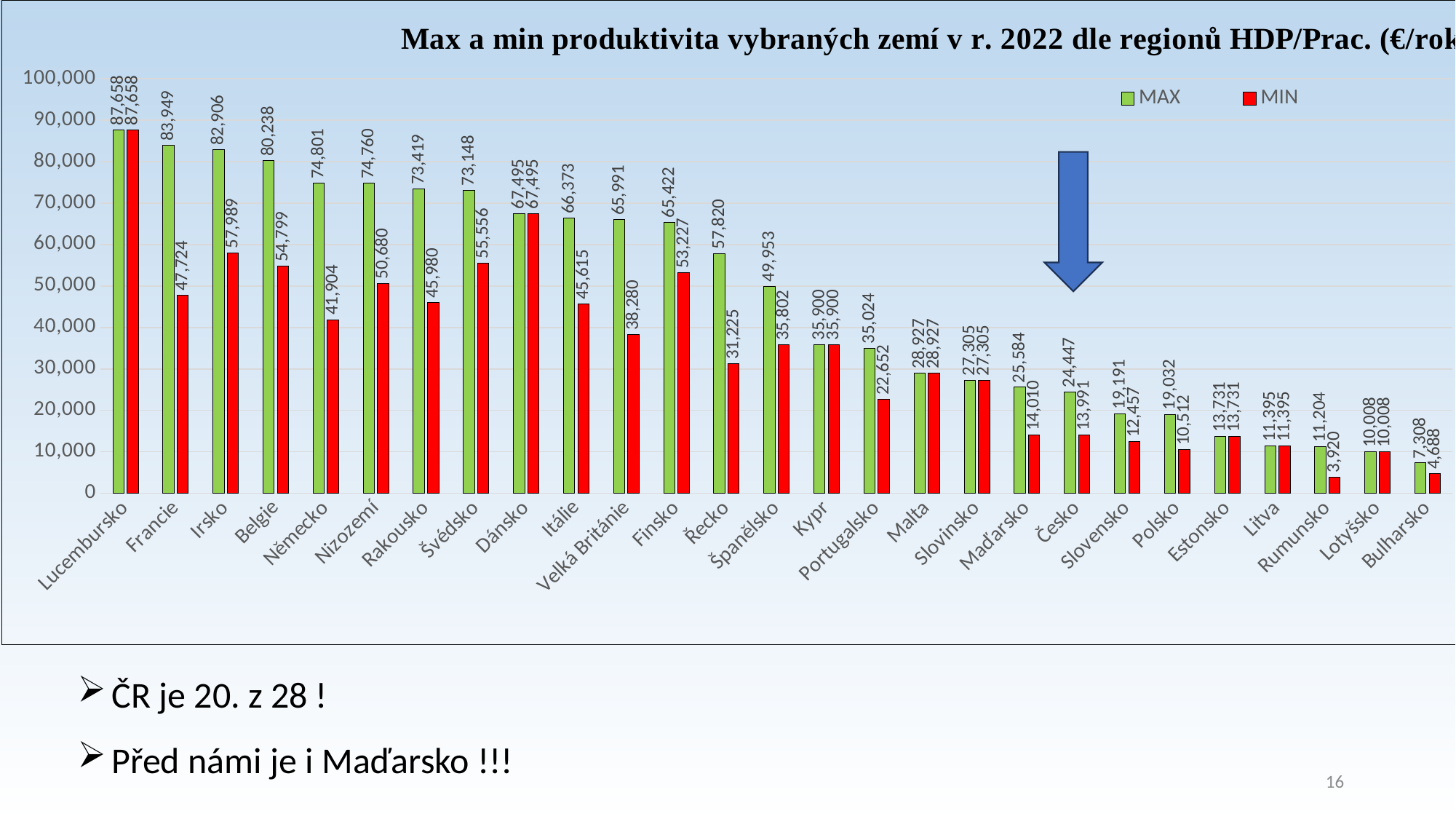
What is the MIN value for Maďarsko? 14,010 Is the MAX value for Řecko greater or less than 50,000? greater How many series does the legend list? 2 How many countries are shown on the x axis? 27 Which country has the lowest MIN value? Rumunsko What is the MIN value for Německo? 41,904 What kind of chart is shown? bar chart Do the MAX values rise or fall from left to right along the x axis? fall What is the MAX value for Česko? 24,447 Which country has the highest MAX value? Lucembursko What is the difference between the MAX and MIN values for Česko? 10,456 Which is larger, the MIN value for Francie or the MIN value for Irsko? Irsko